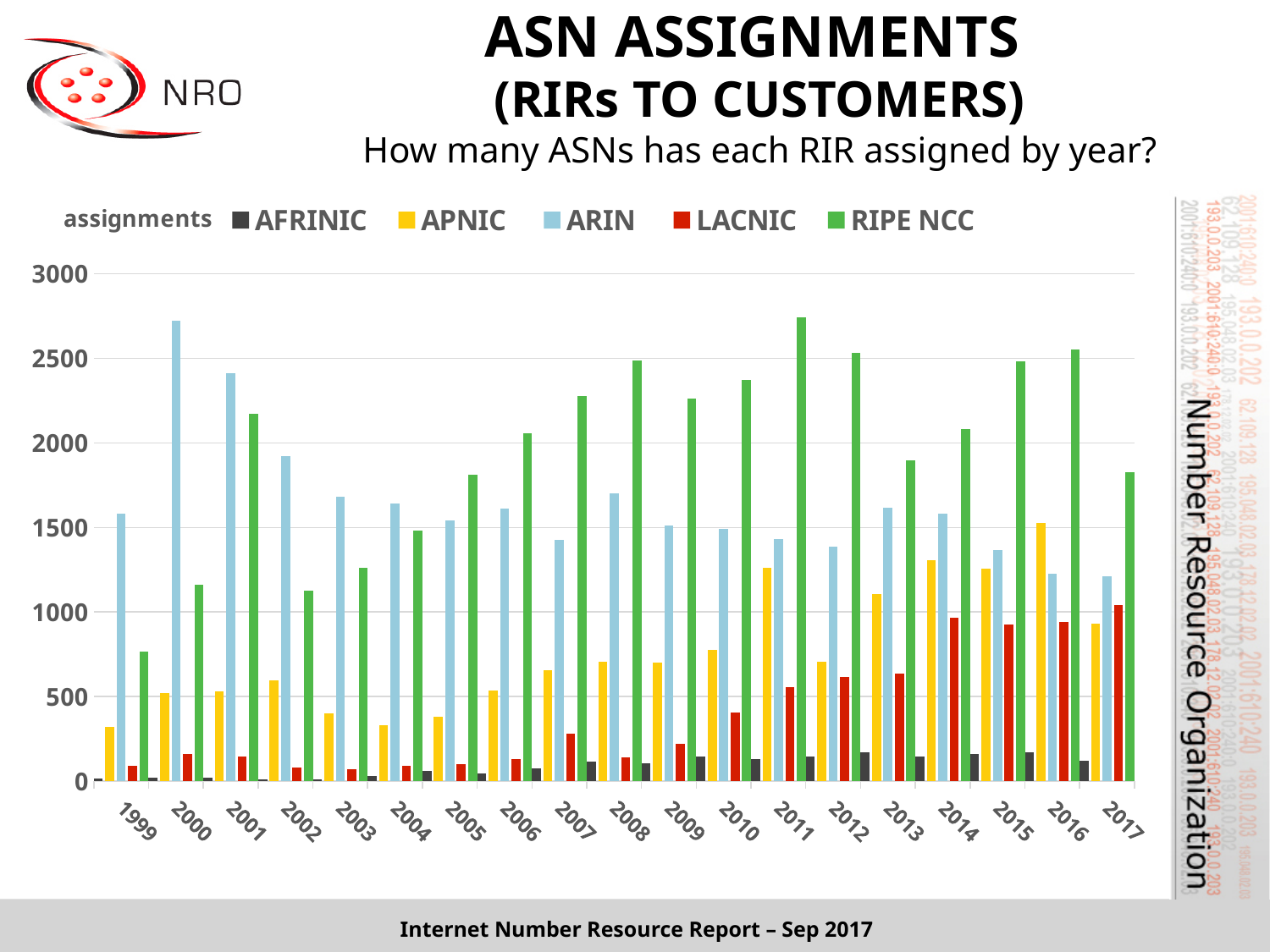
In which year is the ARIN bar highest? 2000 Is the value for ARIN in 2000 greater or less than 2500? greater Which RIR has the lowest value in 2017? AFRINIC In 2017, which is larger, RIPE NCC or ARIN? RIPE NCC How many series does the legend list? 5 Do the LACNIC values generally rise or fall from 1999 to 2017? rise How many years are shown along the x axis? 19 Is the value for LACNIC in 2017 greater or less than 500? greater What kind of chart is shown on the slide? bar chart In 2000, which is larger, ARIN or RIPE NCC? ARIN Is the value for RIPE NCC in 1999 greater or less than 1000? less